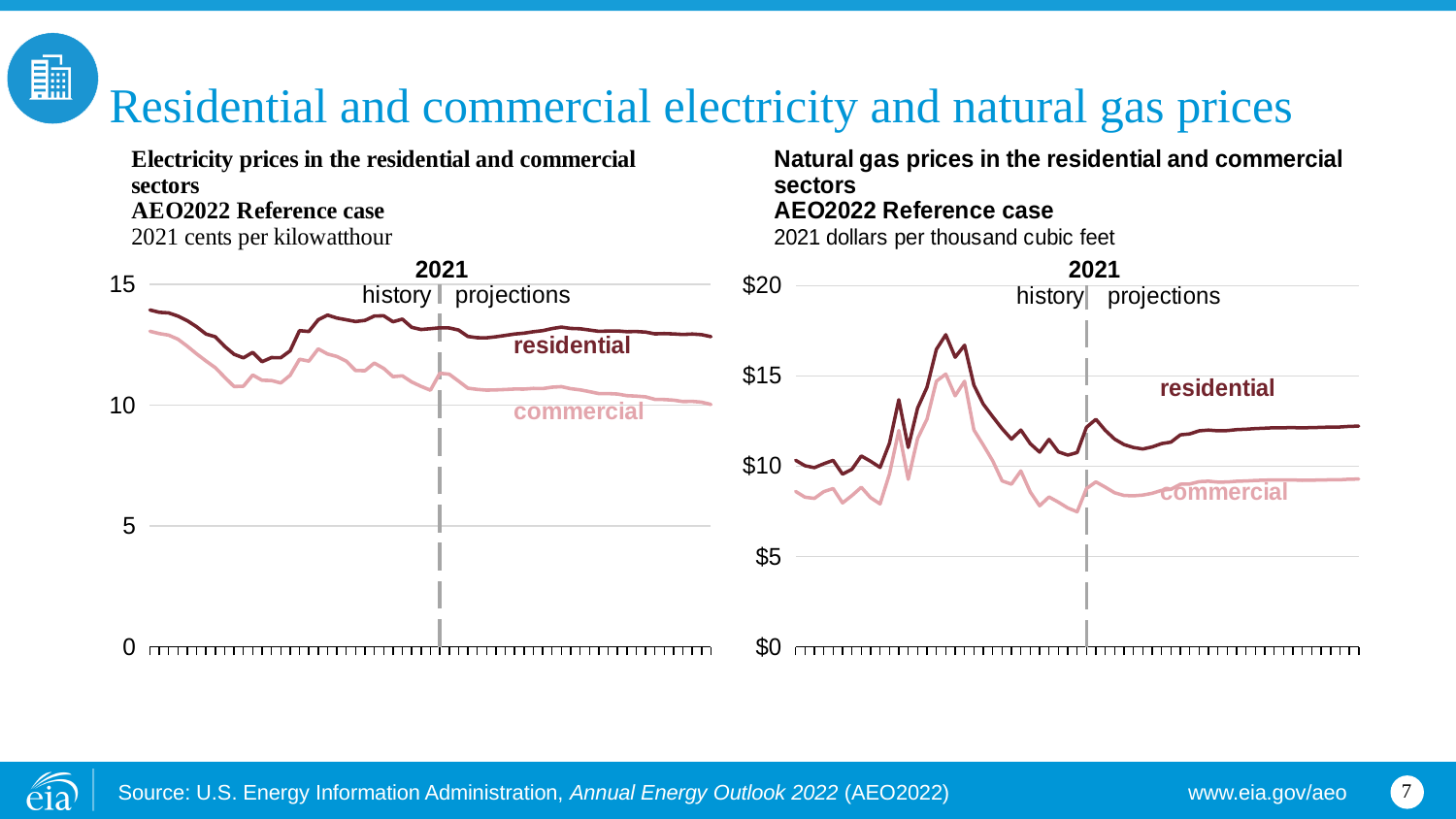
On the 'Natural gas prices in the residential and commercial sectors' chart, which series is higher at the end of the projection period, residential or commercial? residential On the 'Natural gas prices in the residential and commercial sectors' chart, is the peak residential value greater or less than $15? greater What kind of chart is the 'Electricity prices in the residential and commercial sectors' chart? line chart On the 'Electricity prices in the residential and commercial sectors' chart, is the highest commercial value greater or less than 15? less How many series are plotted on the 'Natural gas prices in the residential and commercial sectors' chart? 2 What year does the dashed vertical line separating history from projections mark on both charts? 2021 On the 'Natural gas prices in the residential and commercial sectors' chart, is the commercial value at the end of the projection period greater or less than $10? less How many series are plotted on the 'Electricity prices in the residential and commercial sectors' chart? 2 On the 'Electricity prices in the residential and commercial sectors' chart, which series is higher throughout, residential or commercial? residential On the 'Electricity prices in the residential and commercial sectors' chart, do commercial prices rise or fall over the projection period? fall What kind of chart is the 'Natural gas prices in the residential and commercial sectors' chart? line chart